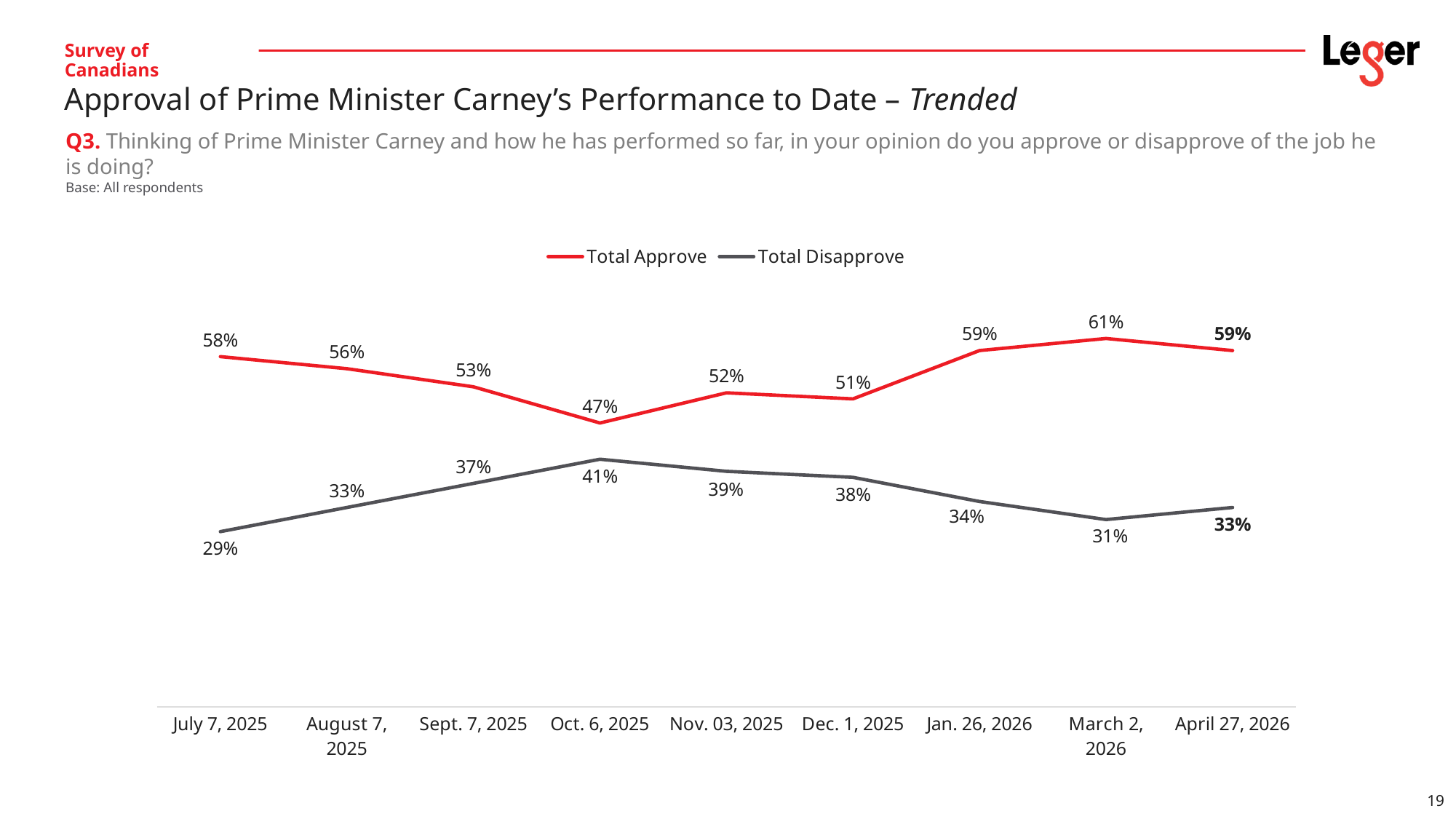
What is the difference between Total Approve and Total Disapprove on April 27, 2026? 26 percentage points On which date is Total Approve highest? March 2, 2026 On which date is Total Approve lowest? Oct. 6, 2025 What is the Total Approve value for July 7, 2025? 58% On which date is Total Disapprove lowest? July 7, 2025 What kind of chart is shown? Line chart How many dates are plotted on the x axis? 9 What is the Total Disapprove value for Oct. 6, 2025? 41% How many series does the legend list? 2 What is the Total Approve value for April 27, 2026? 59% Does Total Approve rise or fall from July 7, 2025 to Oct. 6, 2025? Fall Which is larger on Dec. 1, 2025: Total Approve or Total Disapprove? Total Approve